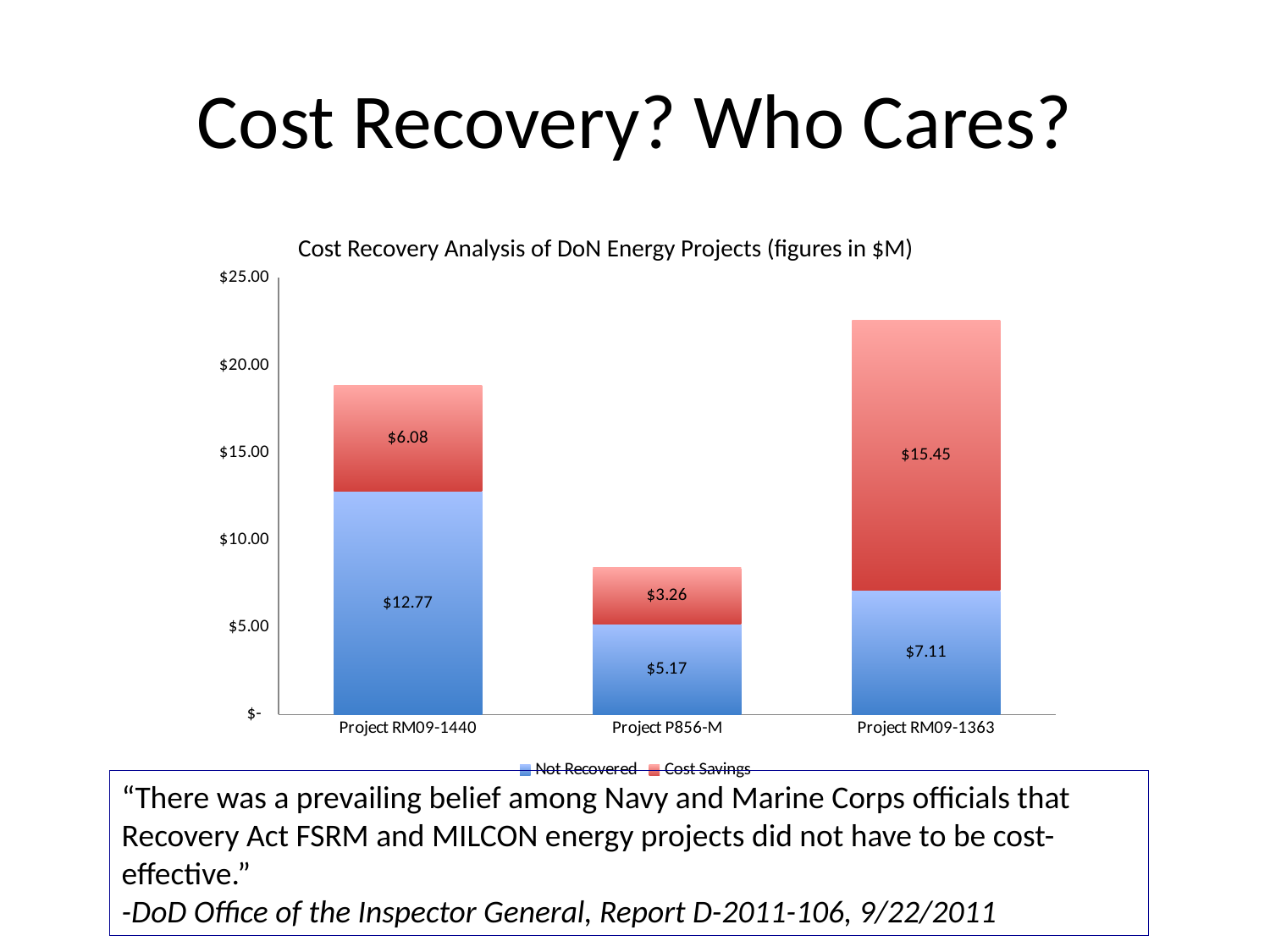
What is the Cost Savings value for Project P856-M? $3.26 What is the total of the stacked bar for Project RM09-1363? $22.56 Which project has the lowest Not Recovered value? Project P856-M What is the total of the stacked bar for Project P856-M? $8.43 What is the Not Recovered value for Project RM09-1440? $12.77 What is the Cost Savings value for Project RM09-1363? $15.45 Which project has the highest Cost Savings value? Project RM09-1363 How many series does the legend list? 2 What kind of chart is shown on the slide? Stacked bar chart What is the difference between the Not Recovered values for Project RM09-1440 and Project RM09-1363? $5.66 How many projects are shown on the x axis? 3 Which is larger: the Cost Savings for Project RM09-1440 or the Cost Savings for Project P856-M? Project RM09-1440